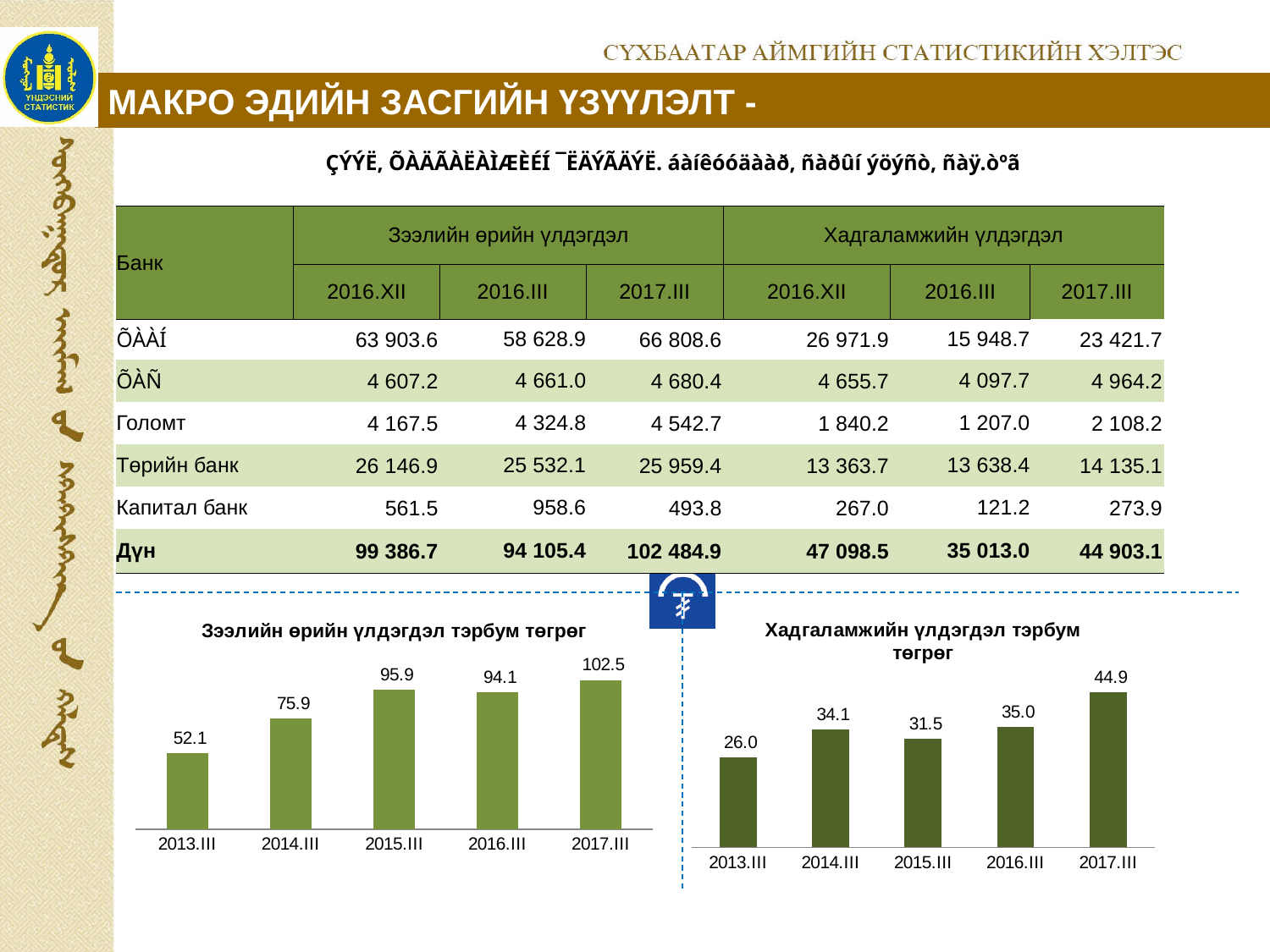
In the chart titled "Зээлийн өрийн үлдэгдэл тэрбум төгрөг", which period has the highest value? 2017.III In the chart titled "Зээлийн өрийн үлдэгдэл тэрбум төгрөг", how many periods are shown on the x axis? 5 In the chart titled "Зээлийн өрийн үлдэгдэл тэрбум төгрөг", which period has the lowest value? 2013.III In the chart titled "Хадгаламжийн үлдэгдэл тэрбум төгрөг", which period has the highest value? 2017.III What kind of chart is the one titled "Хадгаламжийн үлдэгдэл тэрбум төгрөг"? Bar chart In the chart titled "Зээлийн өрийн үлдэгдэл тэрбум төгрөг", which is larger, the value for 2015.III or 2016.III? 2015.III In the chart titled "Хадгаламжийн үлдэгдэл тэрбум төгрөг", what is the value for 2014.III? 34.1 In the chart titled "Зээлийн өрийн үлдэгдэл тэрбум төгрөг", what is the difference between the values for 2017.III and 2013.III? 50.4 In the chart titled "Хадгаламжийн үлдэгдэл тэрбум төгрөг", what is the difference between the values for 2017.III and 2016.III? 9.9 In the chart titled "Хадгаламжийн үлдэгдэл тэрбум төгрөг", which is larger, the value for 2014.III or 2015.III? 2014.III In the chart titled "Зээлийн өрийн үлдэгдэл тэрбум төгрөг", what is the value for 2015.III? 95.9 In the chart titled "Хадгаламжийн үлдэгдэл тэрбум төгрөг", what is the value for 2013.III? 26.0